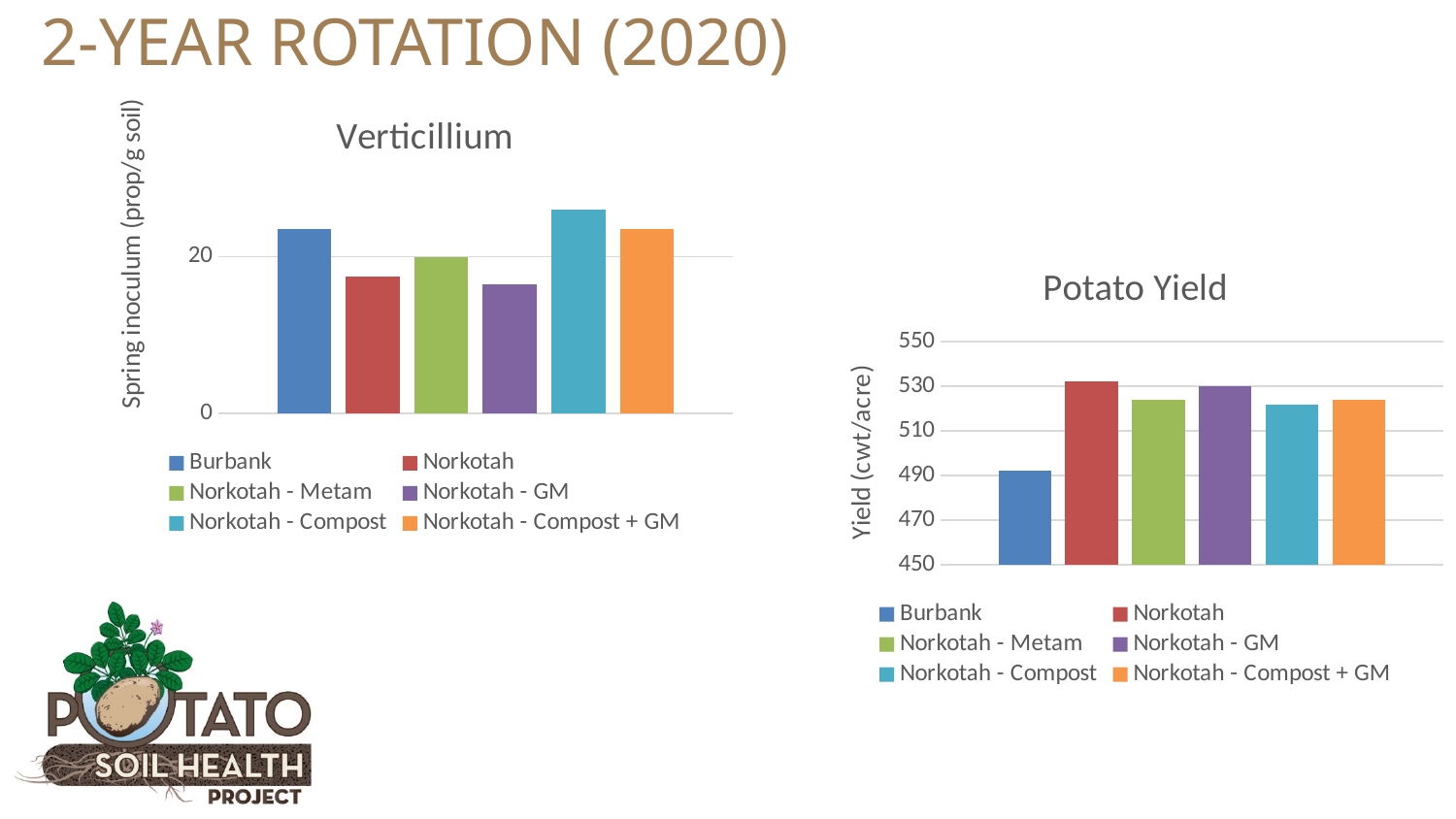
In the Verticillium chart, is the value for Norkotah - GM greater or less than 20? less In the Verticillium chart, is the value for Burbank greater or less than 20? greater In the Verticillium chart, which treatment has the highest spring inoculum? Norkotah - Compost What kind of chart is the Verticillium chart? bar chart In the Potato Yield chart, is the value for Burbank greater or less than 510? less How many series does the legend of the Potato Yield chart list? 6 In the Potato Yield chart, which is larger, the value for Norkotah or the value for Burbank? Norkotah In the Potato Yield chart, which treatment has the lowest yield? Burbank How many bars are plotted in the Verticillium chart? 6 What is the y-axis label of the Potato Yield chart? Yield (cwt/acre) In the Verticillium chart, which is larger, the value for Burbank or the value for Norkotah? Burbank